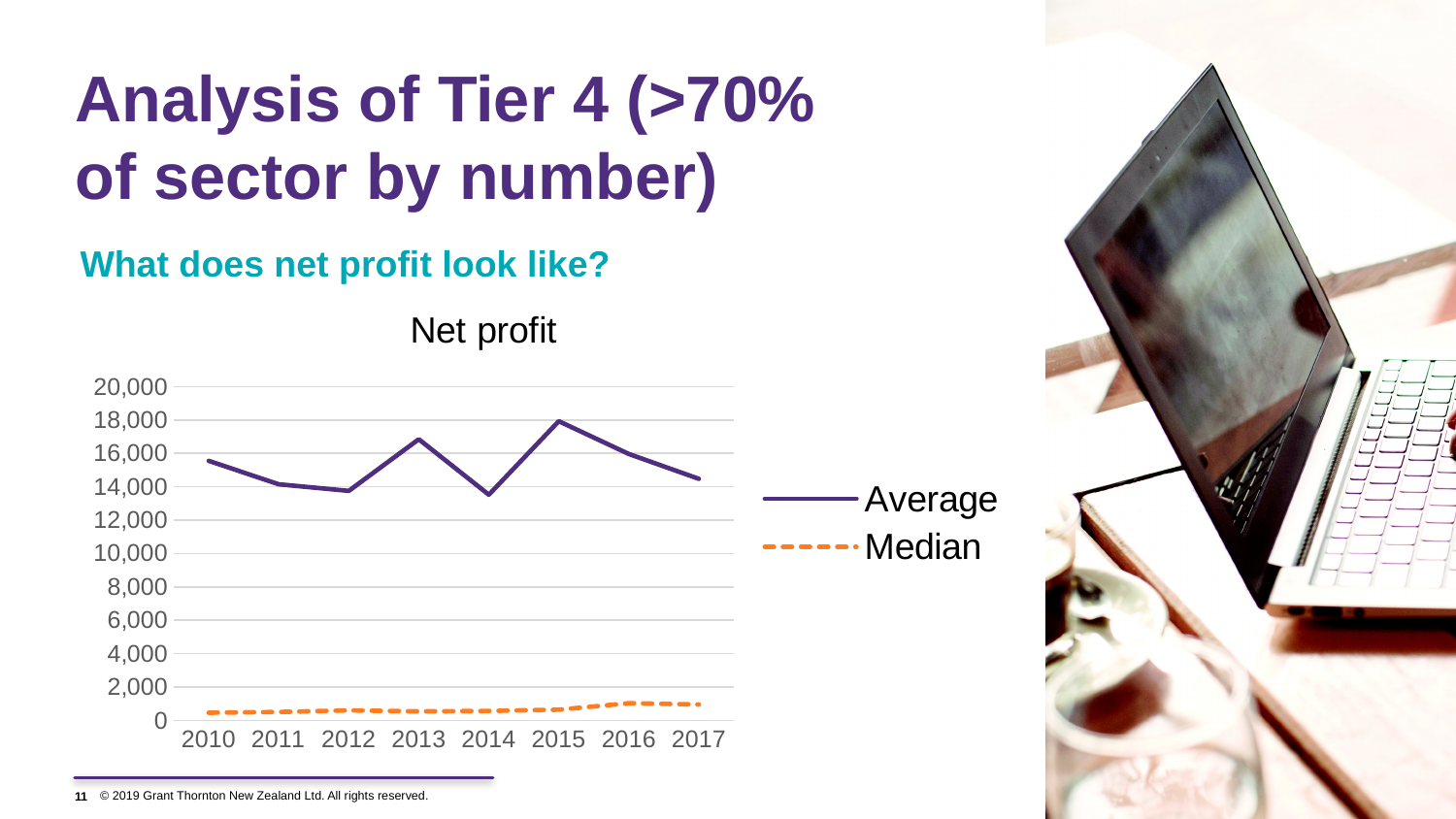
Is the Average value for 2015 greater or less than 16,000? greater Does the Average line rise or fall from 2015 to 2017? Fall How many years are shown on the x axis? 8 Which series is drawn with a dashed line? Median What is the title of the chart? Net profit In which year is the Average net profit highest? 2015 Is the Average value for 2014 greater or less than 16,000? less Which is larger, the Average value for 2015 or the Average value for 2011? 2015 What type of chart is shown on the slide? Line chart In 2010, which series has the higher value, Average or Median? Average Is the Median value for 2017 greater or less than 2,000? less How many series does the legend list? 2